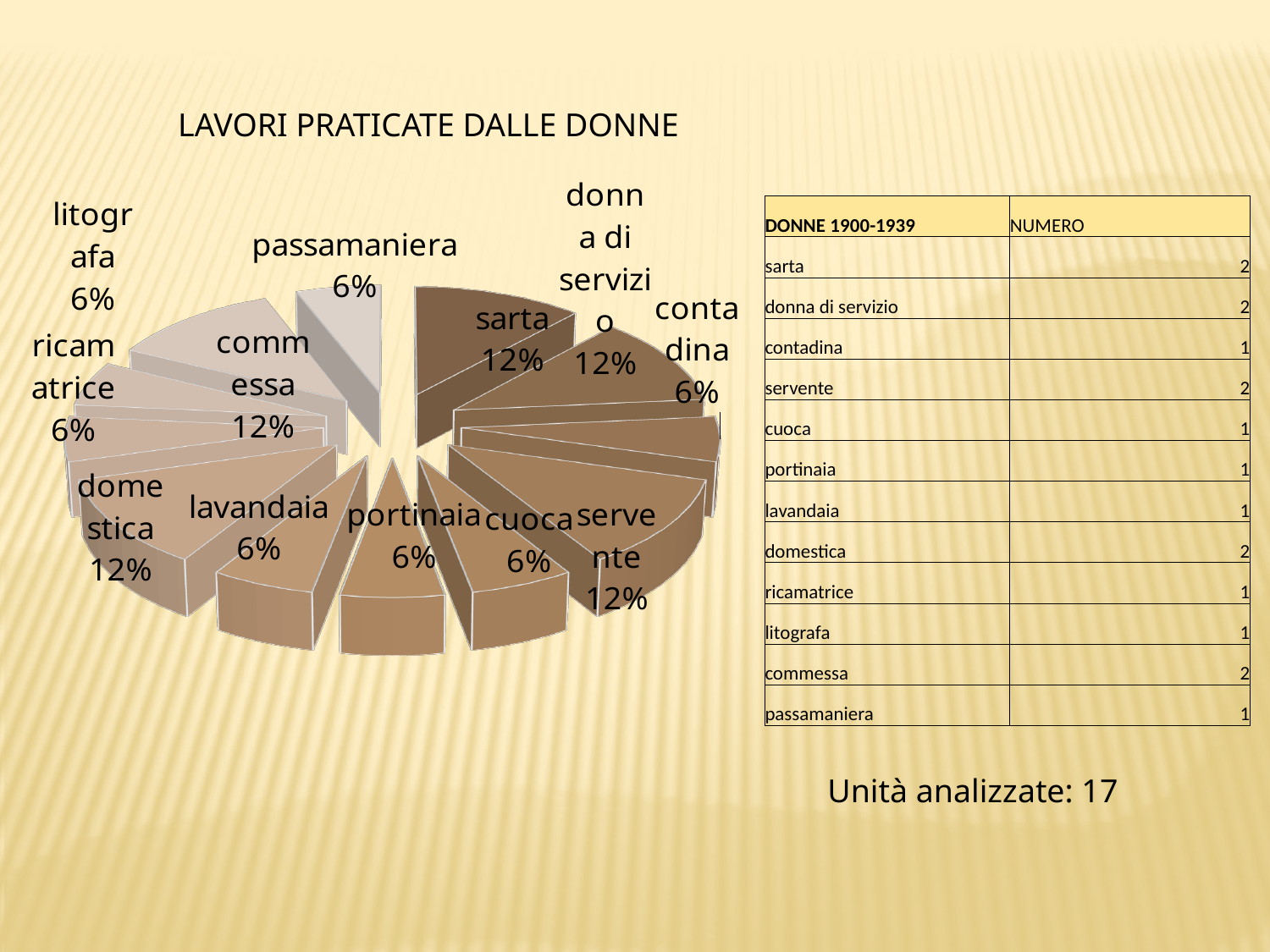
Which is larger, the share for passamaniera or the share for sarta? sarta What kind of chart is shown on the slide? pie chart How many slices does the pie chart have? 12 What percentage is shown for contadina? 6% What percentage of the pie does the sarta slice represent? 12% What is the title of the chart? LAVORI PRATICATE DALLE DONNE What share of the pie is labelled for domestica? 12% What percentage does the commessa slice show? 12% What percentage is shown for lavandaia in the pie chart? 6% What percentage is shown for ricamatrice? 6% Which is larger in the pie chart, the share for servente or the share for cuoca? servente What is the difference between the percentage for donna di servizio and the percentage for portinaia? 6%